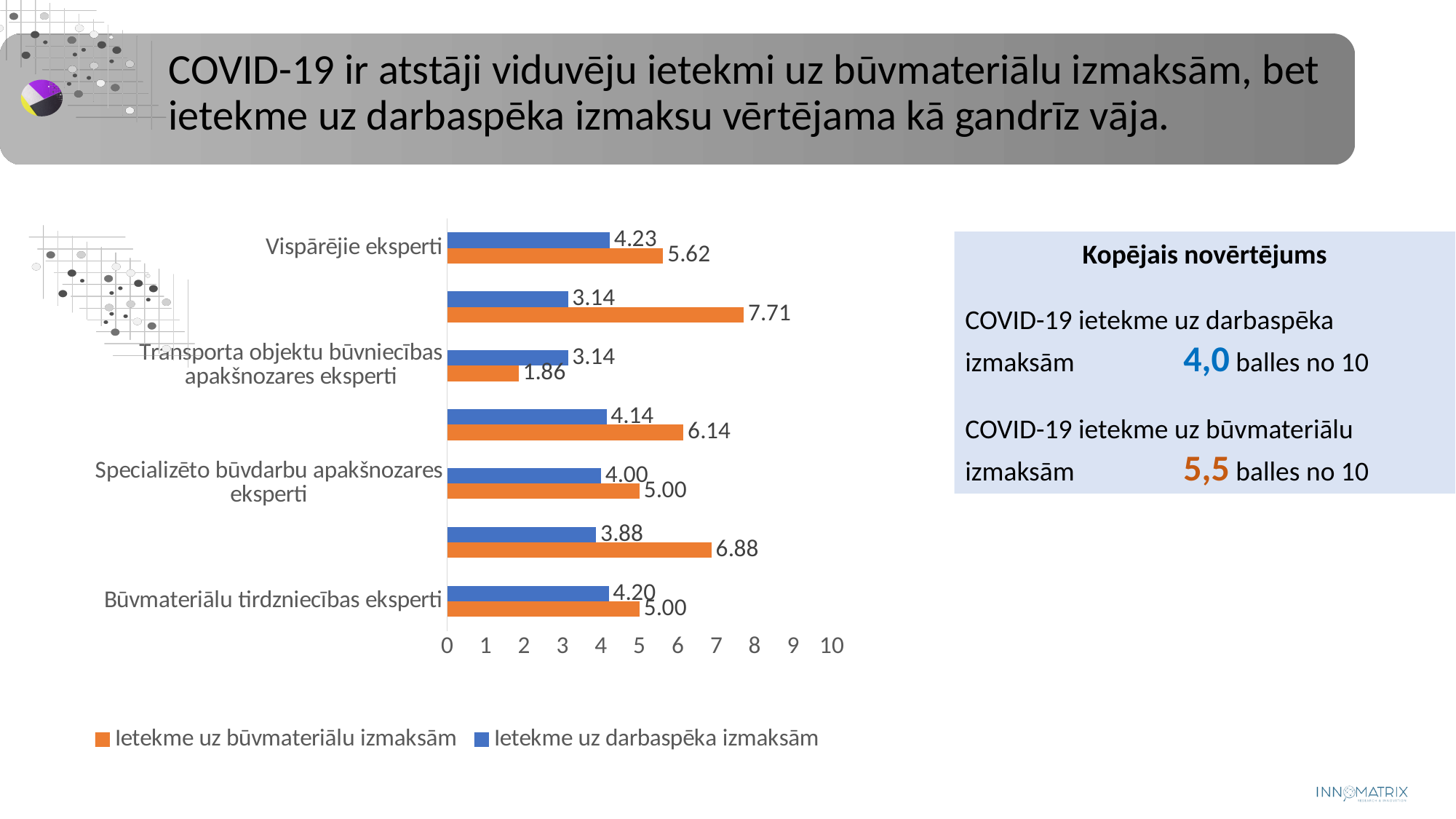
What is the value of Ietekme uz būvmateriālu izmaksām for Vispārējie eksperti? 5.62 What kind of chart is shown on the slide? bar chart Which series is shown in orange in the chart? Ietekme uz būvmateriālu izmaksām What is the value of Ietekme uz darbaspēka izmaksām for Būvmateriālu tirdzniecības eksperti? 4.20 How many series does the chart legend list? 2 What is the value of Ietekme uz būvmateriālu izmaksām for Specializēto būvdarbu apakšnozares eksperti? 5.00 What is the difference between Ietekme uz būvmateriālu izmaksām and Ietekme uz darbaspēka izmaksām for Vispārējie eksperti? 1.39 What is the value of Ietekme uz darbaspēka izmaksām for Vispārējie eksperti? 4.23 What is the value of Ietekme uz būvmateriālu izmaksām for Transporta objektu būvniecības apakšnozares eksperti? 1.86 For Transporta objektu būvniecības apakšnozares eksperti, which is larger: Ietekme uz darbaspēka izmaksām or Ietekme uz būvmateriālu izmaksām? Ietekme uz darbaspēka izmaksām Which labelled category has the lowest value for Ietekme uz būvmateriālu izmaksām? Transporta objektu būvniecības apakšnozares eksperti What is the highest value shown for Ietekme uz būvmateriālu izmaksām in the chart? 7.71